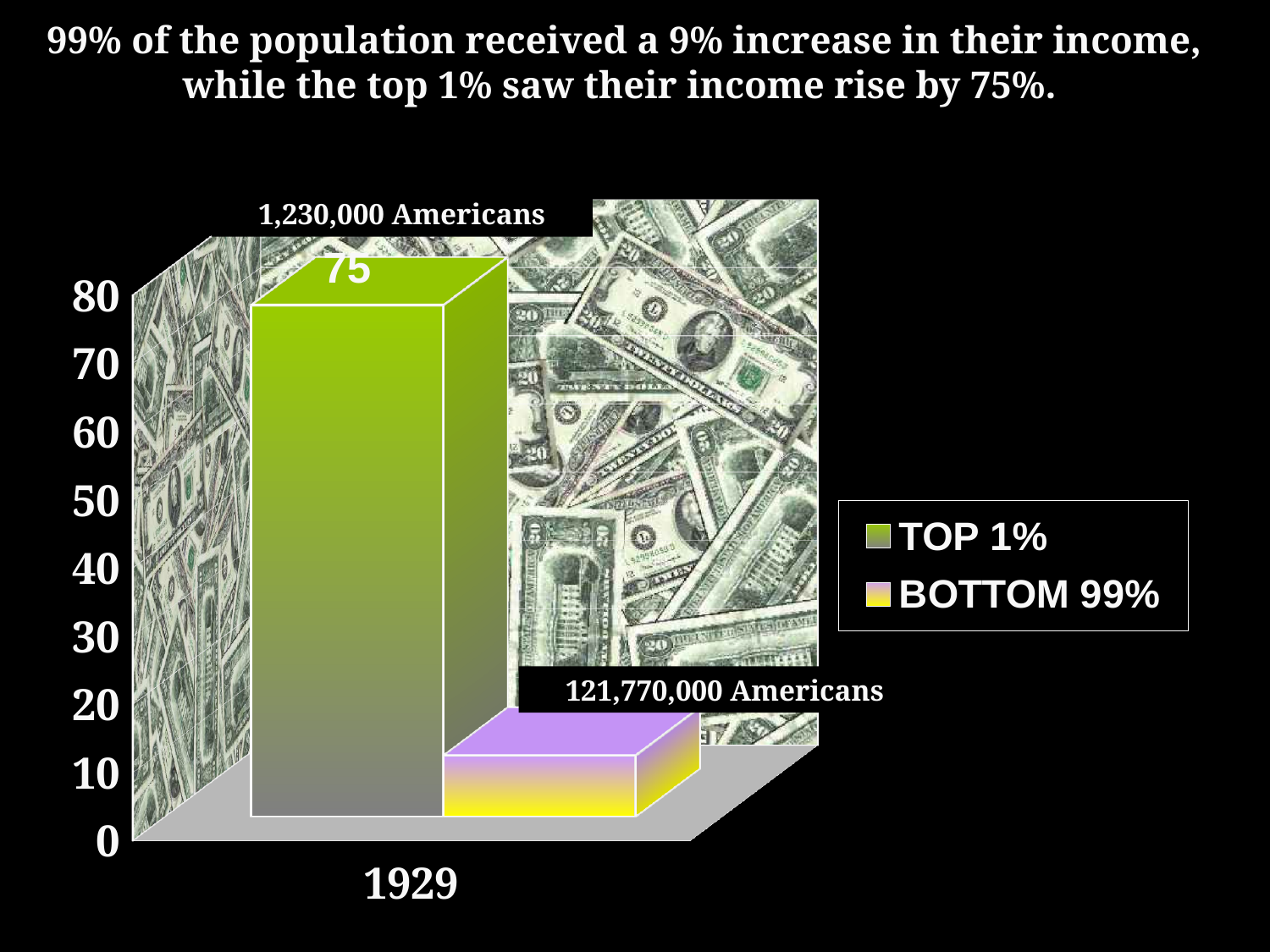
What is the category label on the x axis? 1929 Which is larger, the TOP 1% bar or the BOTTOM 99% bar? TOP 1% What kind of chart is shown on the slide? bar chart How many categories are shown on the x axis? 1 What text label appears above the TOP 1% bar? 1,230,000 Americans How many series does the legend list? 2 Is the value for TOP 1% greater or less than 80? less Is the value for TOP 1% greater or less than 70? greater Which series has the lowest bar? BOTTOM 99% Which series has the highest bar? TOP 1% Is the value for BOTTOM 99% greater or less than 20? less What is the value of the TOP 1% bar? 75